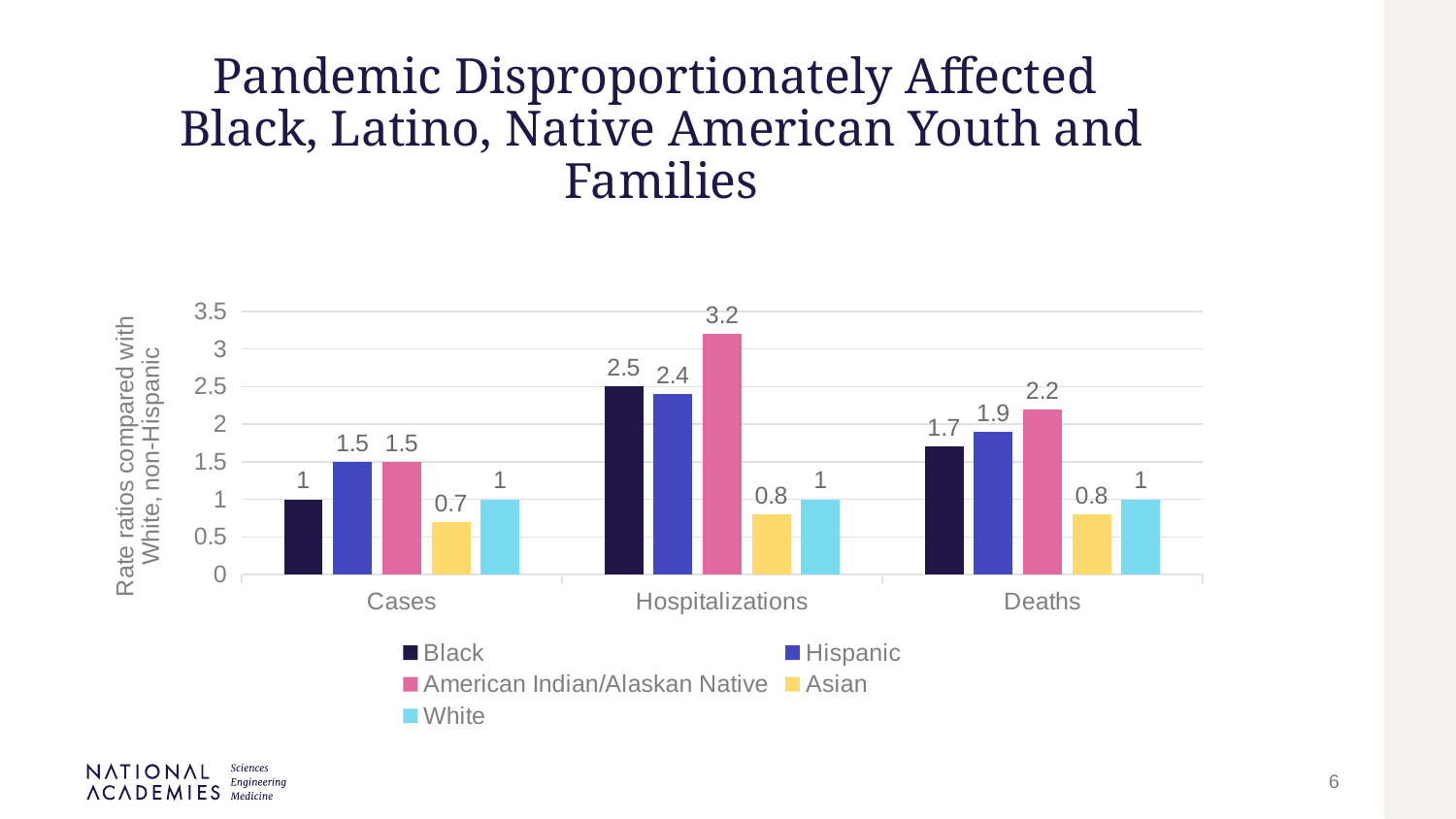
What is the y-axis label of the chart? Rate ratios compared with White, non-Hispanic What is the rate ratio for American Indian/Alaskan Native in the Hospitalizations category? 3.2 How many series does the legend list? 5 How many categories are shown on the x axis? 3 What kind of chart is shown on the slide? Bar chart What is the rate ratio for Black in the Deaths category? 1.7 Which is larger: the Black rate ratio for Hospitalizations or the Black rate ratio for Deaths? Hospitalizations What is the rate ratio for Asian in the Cases category? 0.7 Which group has the lowest rate ratio in the Deaths category? Asian Which group has the highest rate ratio in the Hospitalizations category? American Indian/Alaskan Native What is the difference between the Hispanic and Black rate ratios in the Deaths category? 0.2 What is the rate ratio for White in the Cases category? 1